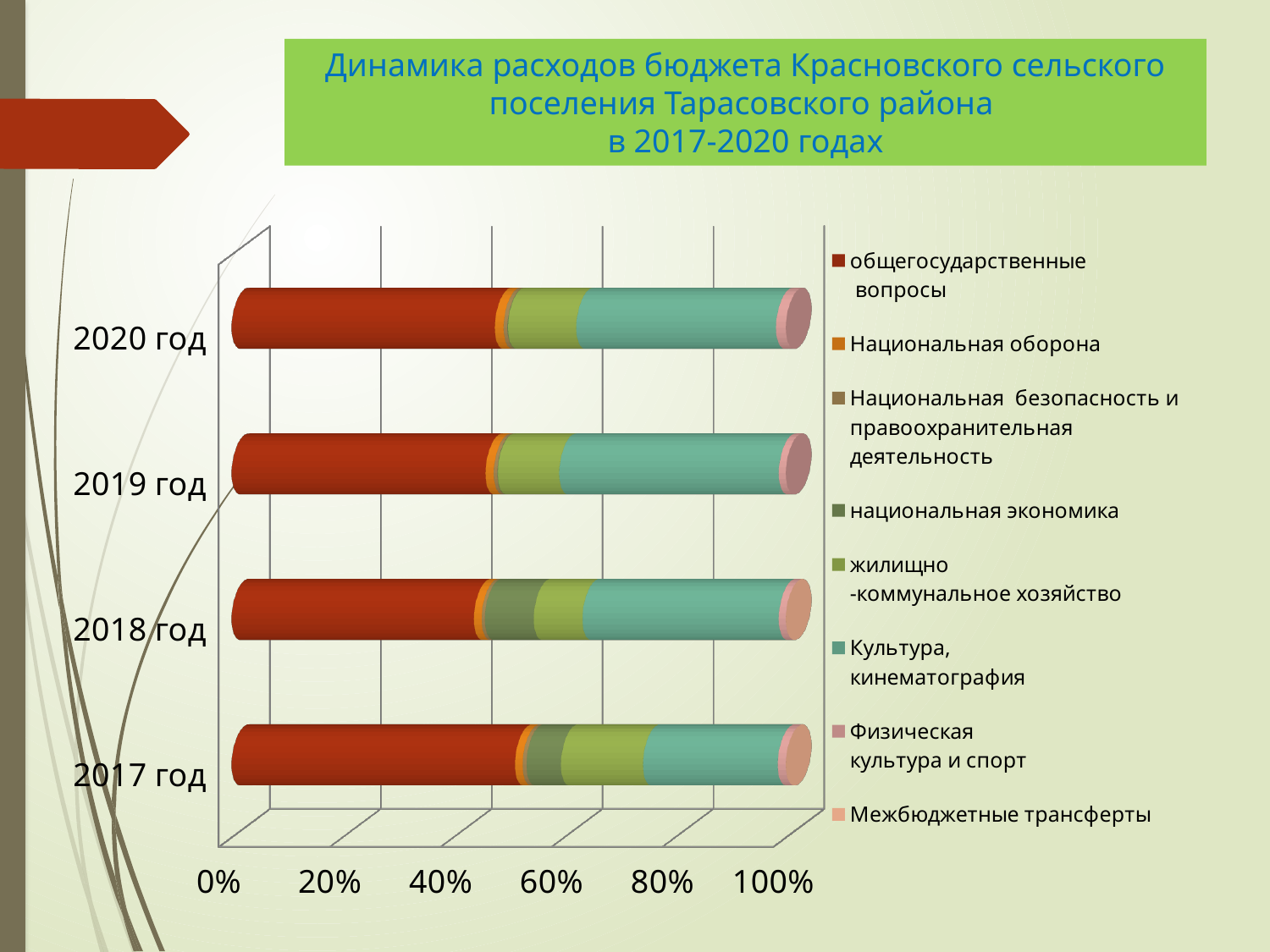
Is the share of общегосударственные вопросы in 2018 год greater or less than 60%? less What kind of chart is shown on the slide? stacked bar chart What is the title of the chart? Динамика расходов бюджета Красновского сельского поселения Тарасовского района в 2017-2020 годах Which legend entry is shown in red? общегосударственные вопросы How many years (categories) are plotted on the chart? 4 What is the total of the stacked bar for 2017 год? 100% Is the share of общегосударственные вопросы in 2020 год greater or less than 40%? greater What is the highest value shown on the horizontal axis? 100% In 2019 год, which is larger: общегосударственные вопросы or Национальная оборона? общегосударственные вопросы How many series does the legend list? 8 In which year is the национальная экономика segment the largest? 2018 год Is the share of Культура, кинематография in 2020 год greater or less than 20%? greater